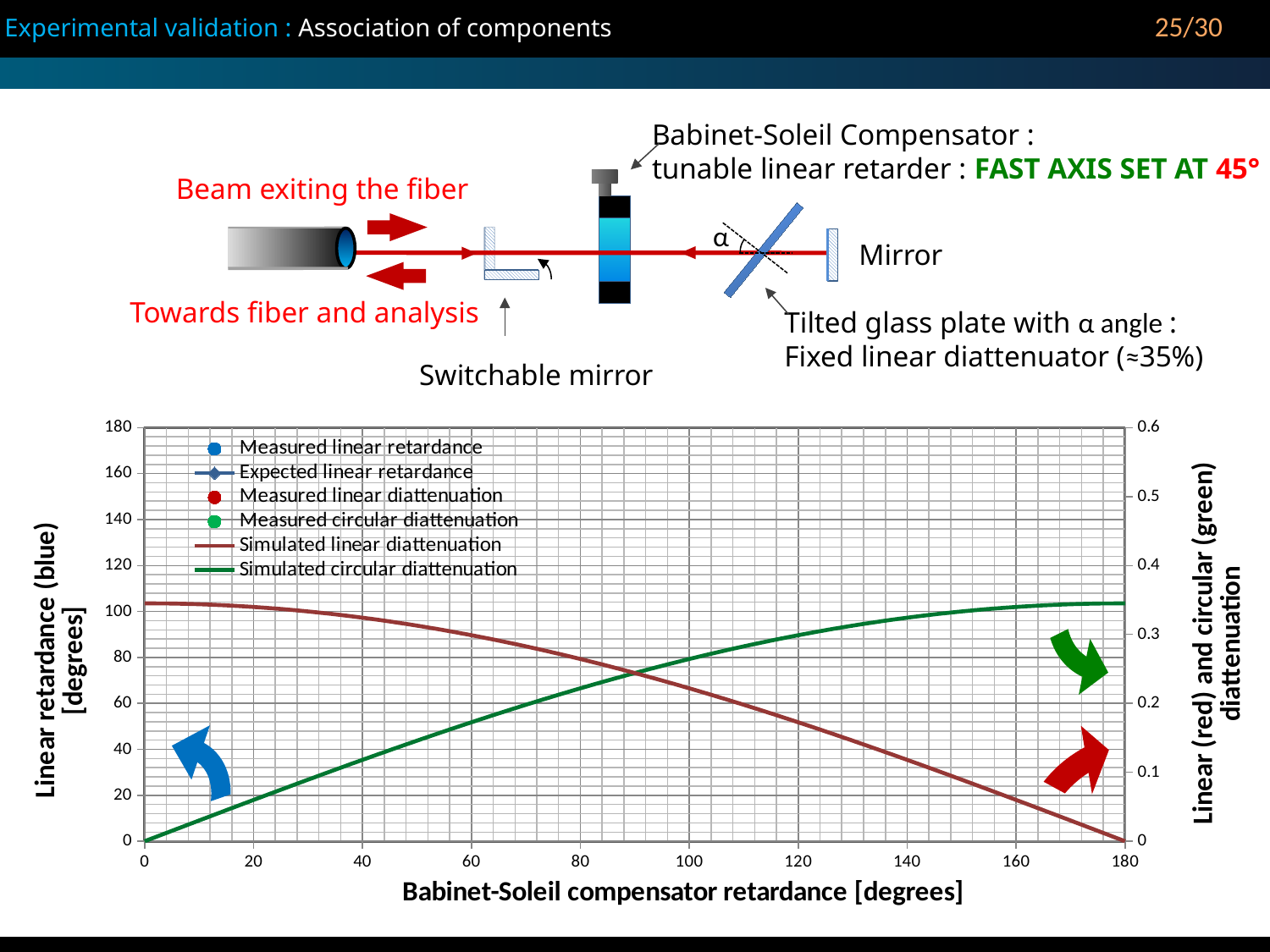
Is the simulated linear diattenuation at a compensator retardance of 0 degrees greater or less than 0.3 on the right axis? greater Which colour is used for the simulated circular diattenuation line? green What is the simulated circular diattenuation at a compensator retardance of 0 degrees? 0 What is the simulated linear diattenuation at a compensator retardance of 180 degrees? 0 At a compensator retardance of 40 degrees, which is larger: the simulated linear diattenuation or the simulated circular diattenuation? simulated linear diattenuation At a compensator retardance of 140 degrees, which is larger: the simulated linear diattenuation or the simulated circular diattenuation? simulated circular diattenuation What is the title of the x axis of the chart? Babinet-Soleil compensator retardance [degrees] Does the simulated circular diattenuation rise or fall as the Babinet-Soleil compensator retardance increases from 0 to 180 degrees? rise How many series does the chart legend list? 6 Does the simulated linear diattenuation rise or fall as the Babinet-Soleil compensator retardance increases from 0 to 180 degrees? fall What kind of chart is shown on the slide? line chart Is the simulated circular diattenuation at a compensator retardance of 100 degrees greater or less than 0.3 on the right axis? less